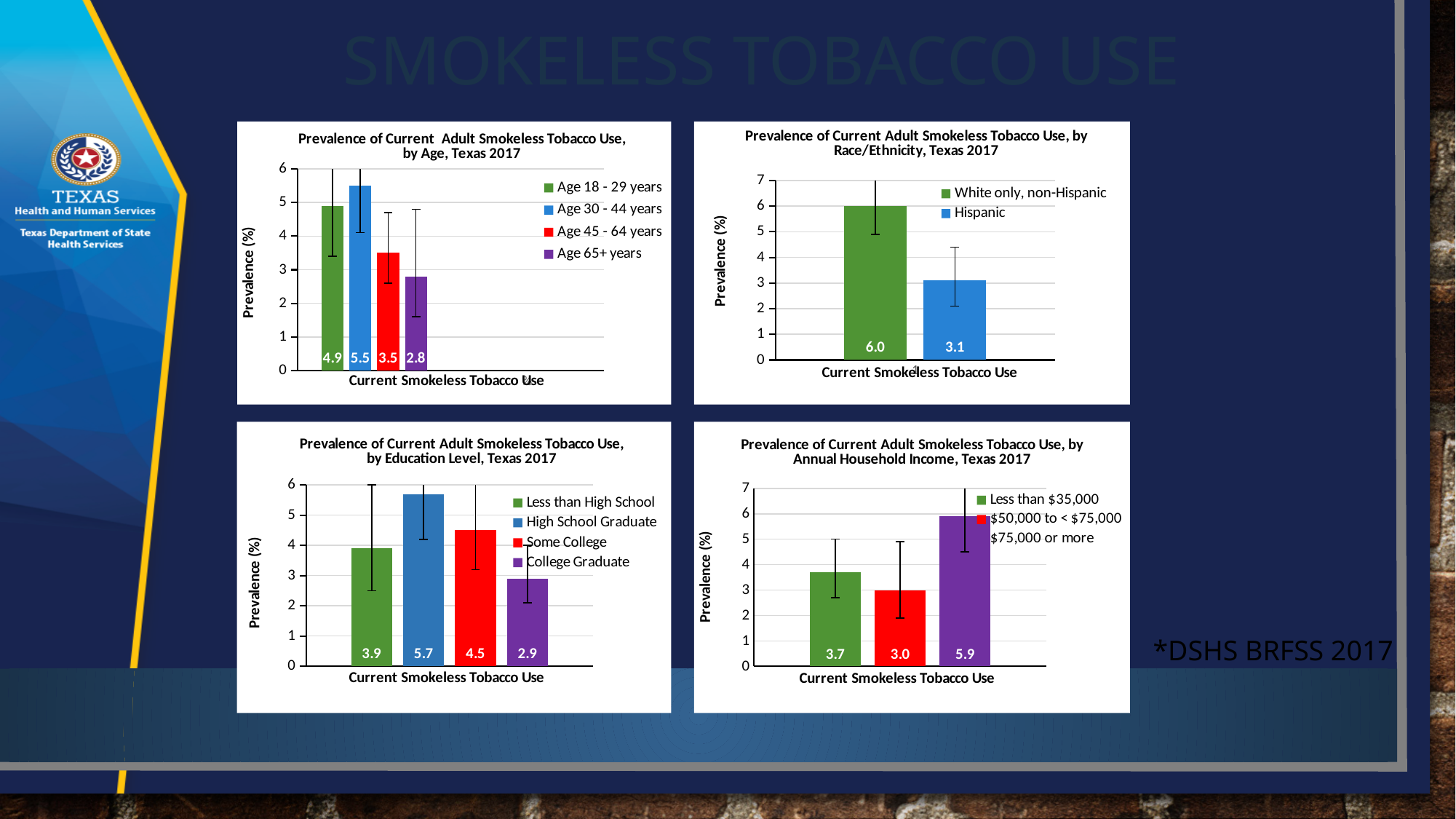
In the chart by Age, what is the difference between Age 30 - 44 years and Age 45 - 64 years? 2.0 In the chart by Annual Household Income, what is the prevalence for $75,000 or more? 5.9 In the chart by Age, which age group has the lowest prevalence? Age 65+ years In the chart by Education Level, what is the prevalence for Some College? 4.5 In the chart by Education Level, which group has the highest prevalence? High School Graduate In the chart by Annual Household Income, how many series does the legend list? 3 In the chart by Race/Ethnicity, what is the prevalence for Hispanic? 3.1 In the chart by Education Level, which is larger: Less than High School or College Graduate? Less than High School In the chart by Age, what is the prevalence for Age 30 - 44 years? 5.5 In the chart by Race/Ethnicity, what is the difference between White only, non-Hispanic and Hispanic? 2.9 In the chart by Race/Ethnicity, how many series does the legend list? 2 What kind of chart is the chart by Annual Household Income? Bar chart